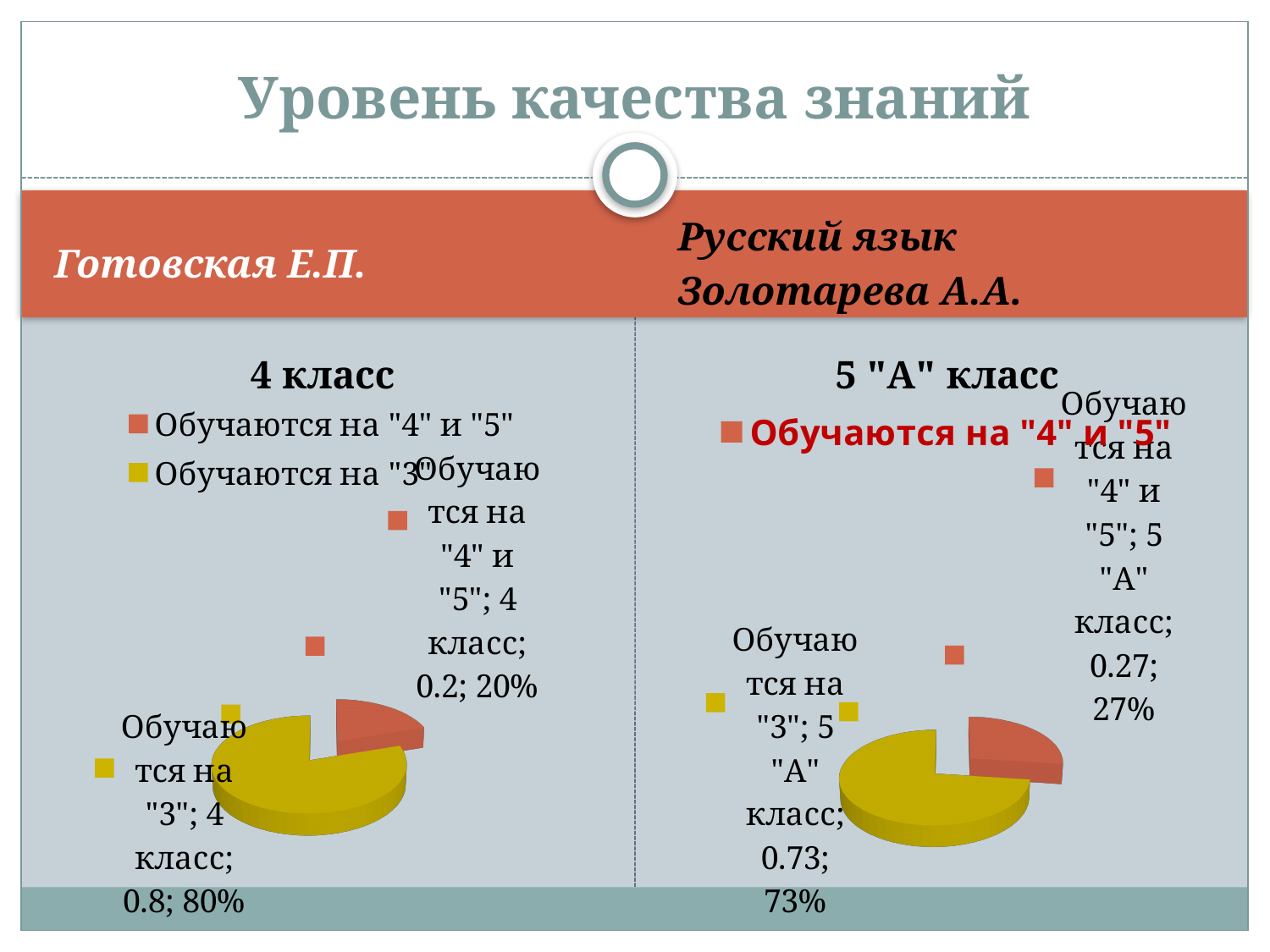
Which chart has the larger share for Обучаются на "4" и "5": "4 класс" or "5 "А" класс"? 5 "А" класс In the "4 класс" chart, which slice is the largest? Обучаются на "3" In the "5 "А" класс" chart, which slice is the smallest? Обучаются на "4" и "5" In the "4 класс" chart, what is the difference in percentage points between the Обучаются на "3" slice and the Обучаются на "4" и "5" slice? 60% How many slices does the "5 "А" класс" pie chart have? 2 What type of chart is used for "4 класс"? Pie chart In the "4 класс" chart, what value is printed for the Обучаются на "3" slice before the percentage? 0.8 In the "5 "А" класс" chart, what value is printed for the Обучаются на "4" и "5" slice before the percentage? 0.27 In the "5 "А" класс" chart, what share of the pie is labelled Обучаются на "3"? 73% In the "4 класс" chart, what share of the pie is labelled Обучаются на "4" и "5"? 20% In the "4 класс" chart, what share of the pie is labelled Обучаются на "3"? 80%